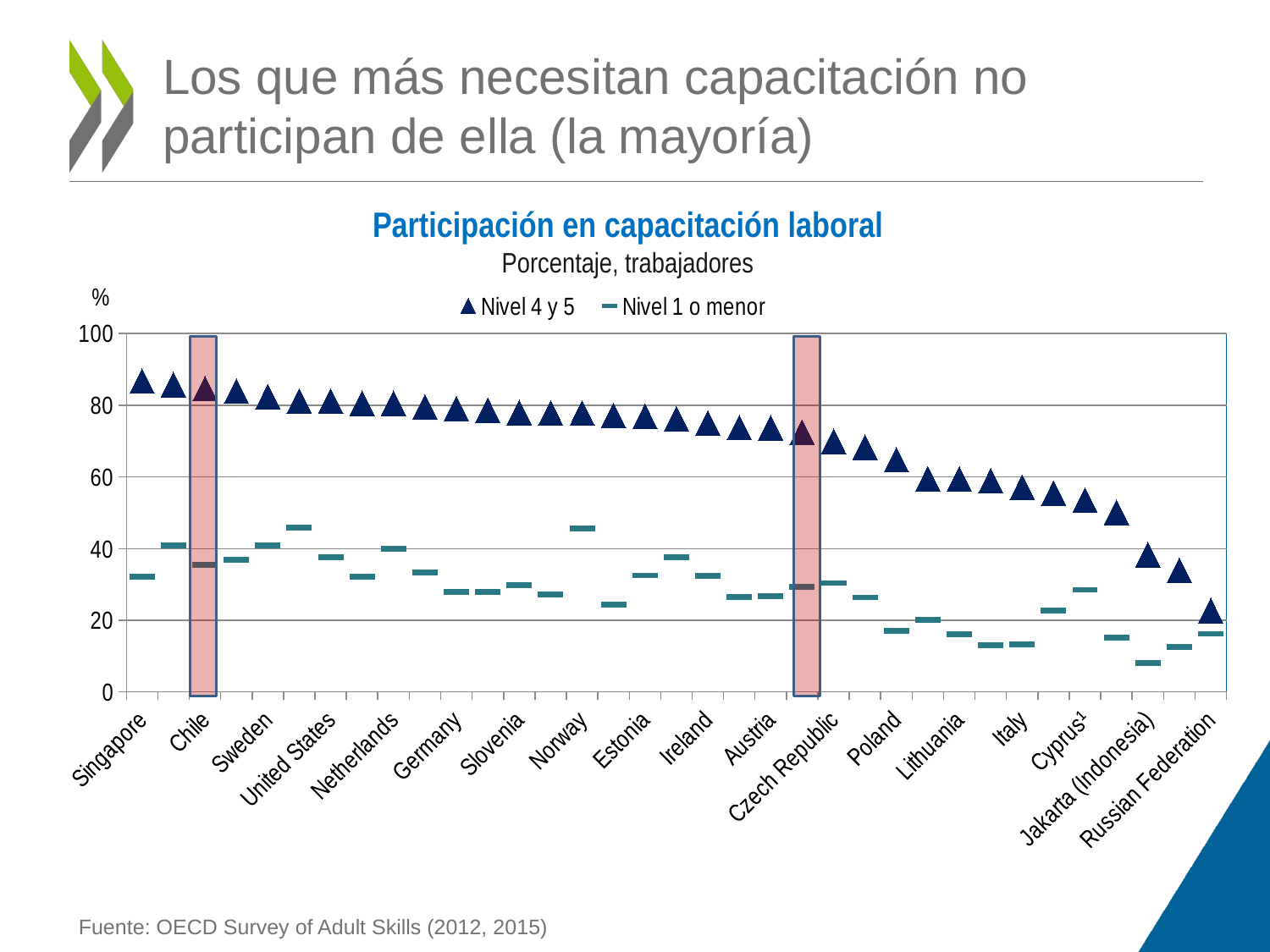
Is the Nivel 4 y 5 value for Czech Republic greater or less than 60? greater Is the Nivel 4 y 5 value for Singapore greater or less than 80? greater What is the title of the chart? Participación en capacitación laboral Is the Nivel 1 o menor value for Jakarta (Indonesia) greater or less than 20? less How many series does the chart legend list? 2 Which country has the lowest Nivel 4 y 5 value? Russian Federation Which country has the lowest Nivel 1 o menor value? Jakarta (Indonesia) Do the Nivel 4 y 5 values rise or fall from left to right along the x axis? fall What are the two series named in the legend? Nivel 4 y 5 and Nivel 1 o menor